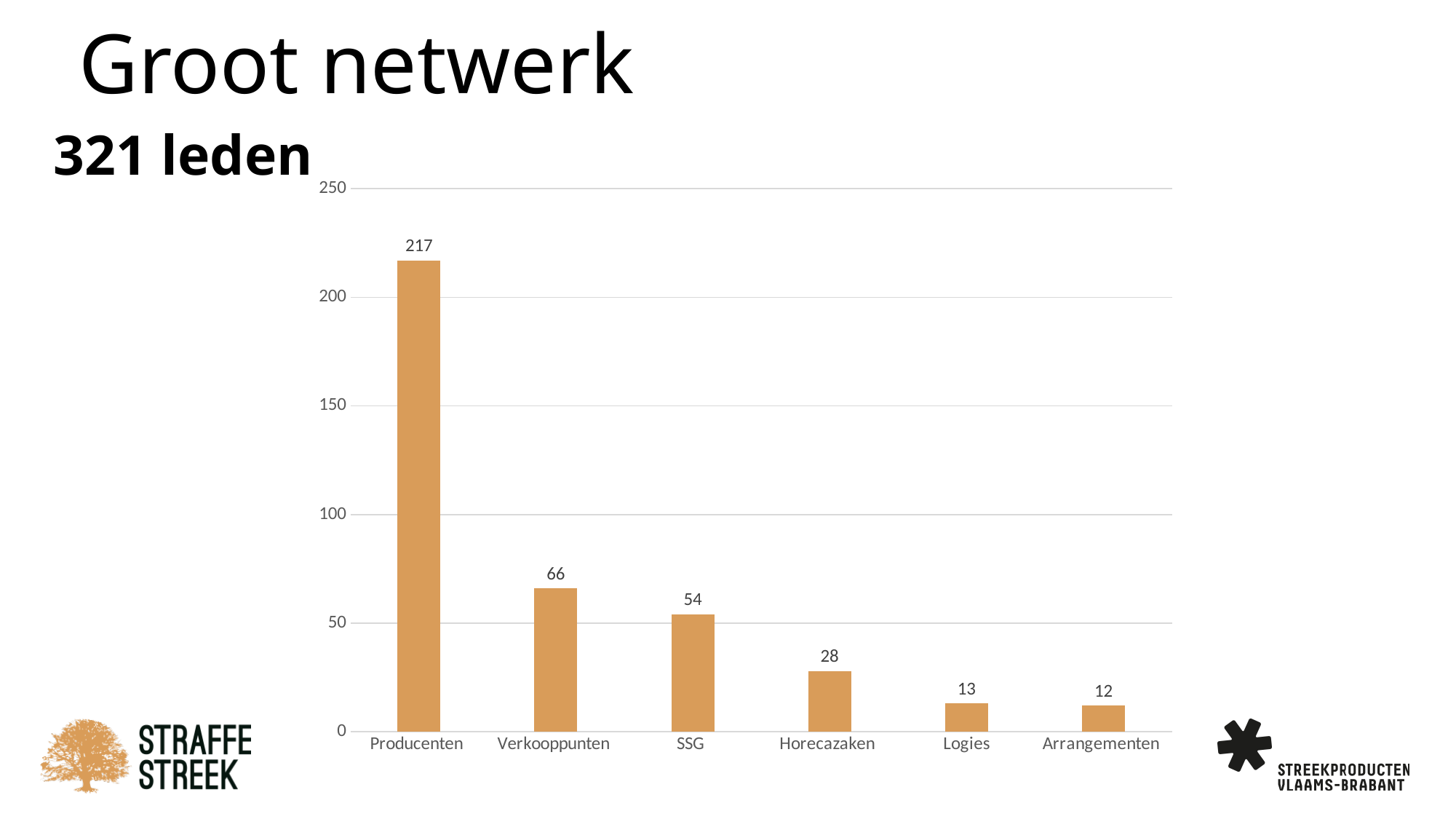
What is the value for Producenten? 217 What is the value for Verkooppunten? 66 Which category has the highest value? Producenten What is the difference between the values for SSG and Horecazaken? 26 Which is larger, the value for Verkooppunten or the value for SSG? Verkooppunten What is the difference between the values for Producenten and Verkooppunten? 151 What is the value for Arrangementen? 12 How many categories are shown on the x axis? 6 Which category has the lowest value? Arrangementen Do the values rise or fall from left to right along the x axis? Fall What is the value for Horecazaken? 28 What kind of chart is shown on the slide? Bar chart